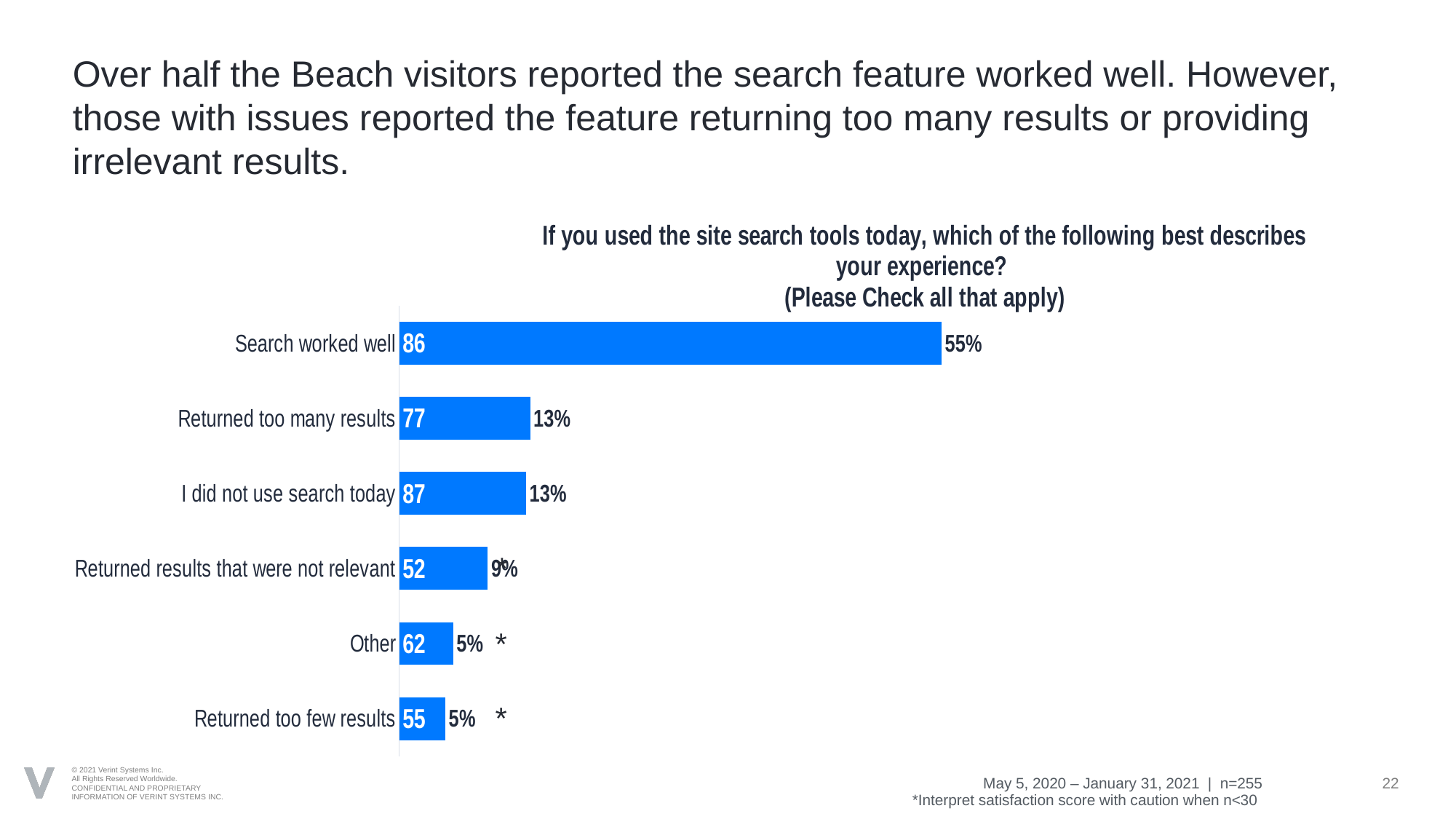
What number is printed inside the bar for 'I did not use search today'? 87 Which has a larger percentage, 'Returned results that were not relevant' or 'Other'? Returned results that were not relevant What percentage of respondents said the search worked well? 55% How many categories are shown in the chart? 6 What kind of chart is shown on the slide? Bar chart Which two categories are marked with an asterisk? Other and Returned too few results Which category has the highest percentage? Search worked well What is the difference in percentage points between 'Returned results that were not relevant' and 'Returned too few results'? 4 What percentage of respondents said the search returned too many results? 13% What is the difference in percentage points between 'Search worked well' and 'Returned too many results'? 42 What percentage of respondents said the search returned results that were not relevant? 9% What percentage of respondents said the search returned too few results? 5%